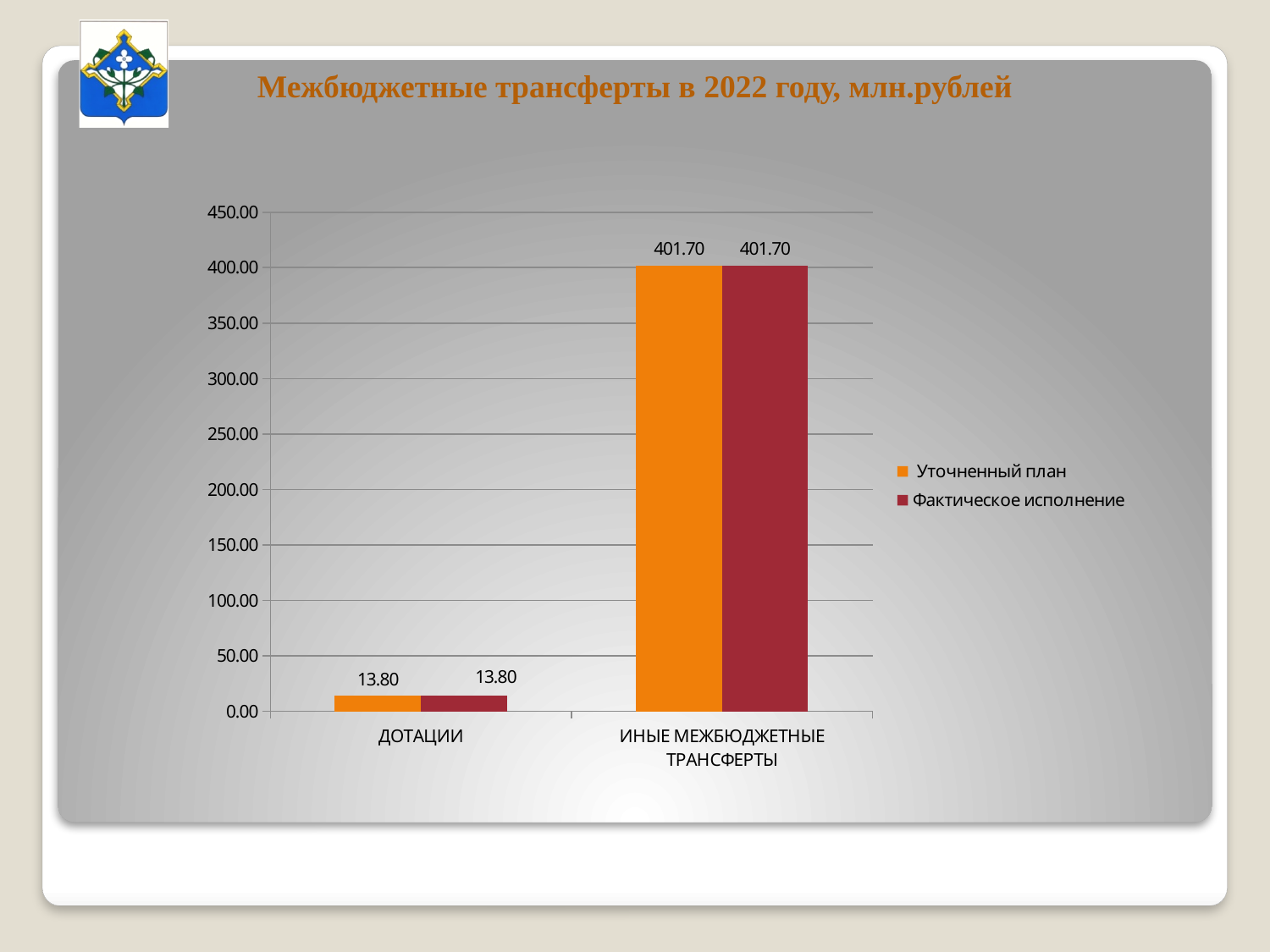
Is the value of Фактическое исполнение for ИНЫЕ МЕЖБЮДЖЕТНЫЕ ТРАНСФЕРТЫ greater or less than 350.00? greater How many categories are shown on the x axis? 2 What is the value of Фактическое исполнение for ИНЫЕ МЕЖБЮДЖЕТНЫЕ ТРАНСФЕРТЫ? 401.70 What kind of chart is shown on the slide? bar chart Which is larger: Уточненный план for ДОТАЦИИ or Уточненный план for ИНЫЕ МЕЖБЮДЖЕТНЫЕ ТРАНСФЕРТЫ? ИНЫЕ МЕЖБЮДЖЕТНЫЕ ТРАНСФЕРТЫ Which category has the lowest value for Фактическое исполнение? ДОТАЦИИ What is the difference between the Уточненный план values for ИНЫЕ МЕЖБЮДЖЕТНЫЕ ТРАНСФЕРТЫ and ДОТАЦИИ? 387.90 What is the title of the chart? Межбюджетные трансферты в 2022 году, млн.рублей How many series does the legend list? 2 Which category has the highest value for Уточненный план? ИНЫЕ МЕЖБЮДЖЕТНЫЕ ТРАНСФЕРТЫ What is the value of Уточненный план for ДОТАЦИИ? 13.80 What is the value of Уточненный план for ИНЫЕ МЕЖБЮДЖЕТНЫЕ ТРАНСФЕРТЫ? 401.70